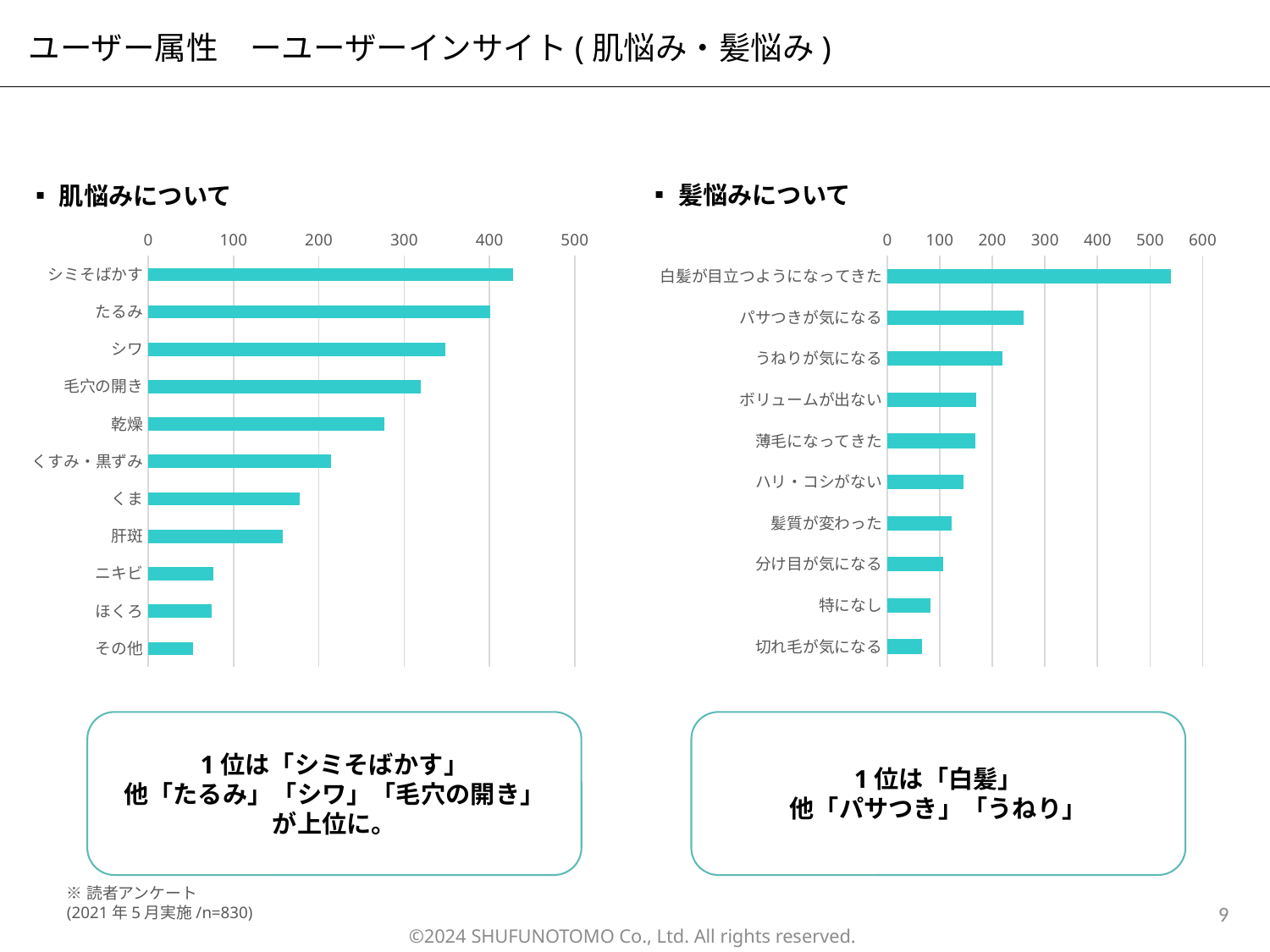
How many categories are shown in the 髪悩みについて chart? 10 In the 肌悩みについて chart, is the value for シミそばかす greater or less than 400? greater In the 髪悩みについて chart, is the value for 白髪が目立つようになってきた greater or less than 500? greater In the 髪悩みについて chart, which is larger, the value for パサつきが気になる or the value for 髪質が変わった? パサつきが気になる In the 髪悩みについて chart, which category has the lowest value? 切れ毛が気になる In the 肌悩みについて chart, which category has the lowest value? その他 In the 肌悩みについて chart, is the value for 乾燥 greater or less than 300? less What kind of chart is the 髪悩みについて chart? bar chart In the 髪悩みについて chart, which category has the highest value? 白髪が目立つようになってきた How many categories are shown in the 肌悩みについて chart? 11 In the 肌悩みについて chart, which category has the highest value? シミそばかす In the 肌悩みについて chart, which is larger, the value for シワ or the value for くま? シワ